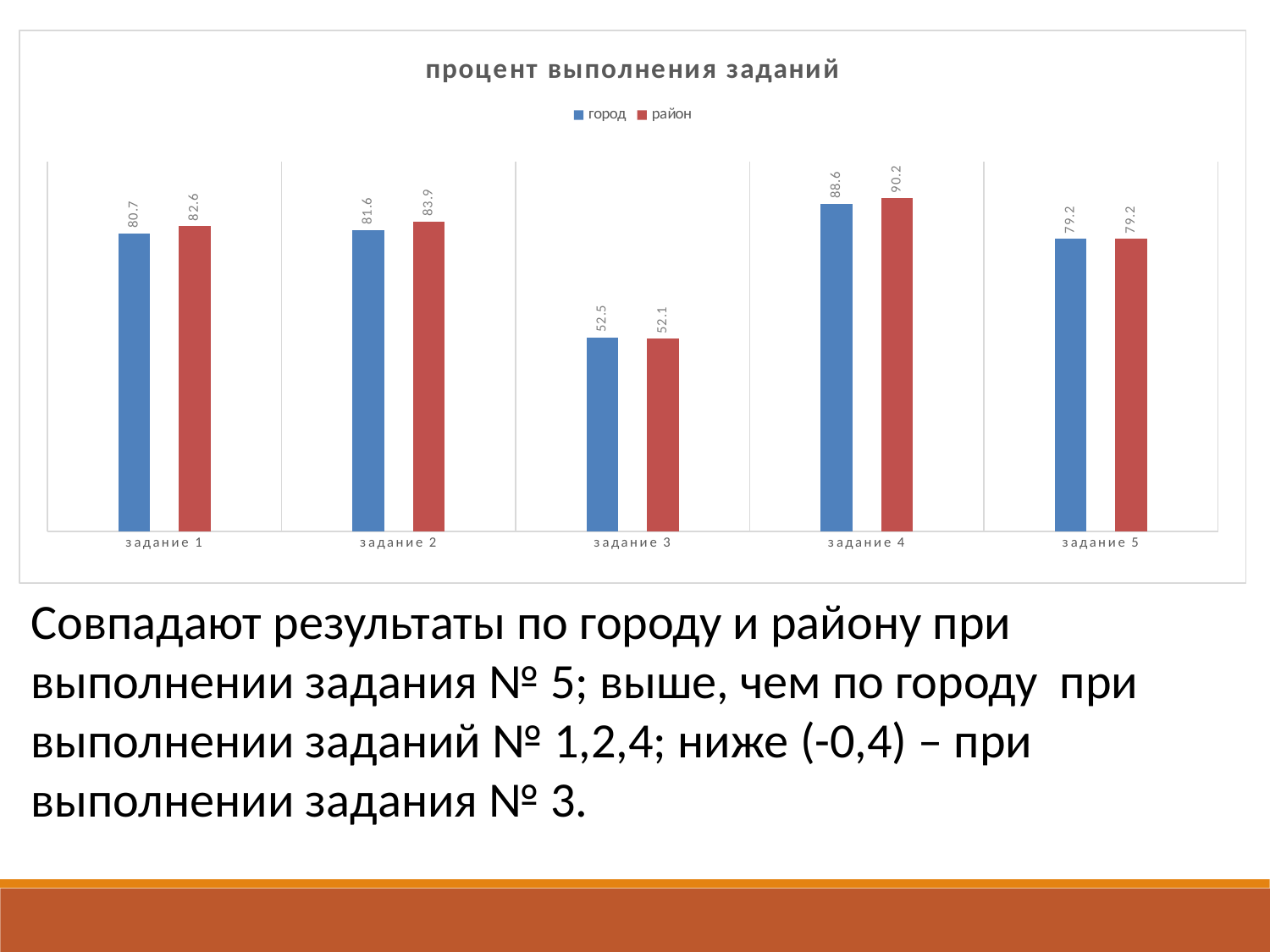
How many tasks (categories) are shown on the x axis? 5 Which is larger for задание 4: город or район? район Which task has the highest value for район? задание 4 What is the value for город for задание 1? 80.7 What is the difference between район and город for задание 2? 2.3 What is the value for район for задание 3? 52.1 How many series does the legend list? 2 What is the value for район for задание 4? 90.2 What is the difference between город and район for задание 3? 0.4 Which task has the lowest value for город? задание 3 What is the title of the chart? процент выполнения заданий What kind of chart is shown on the slide? bar chart